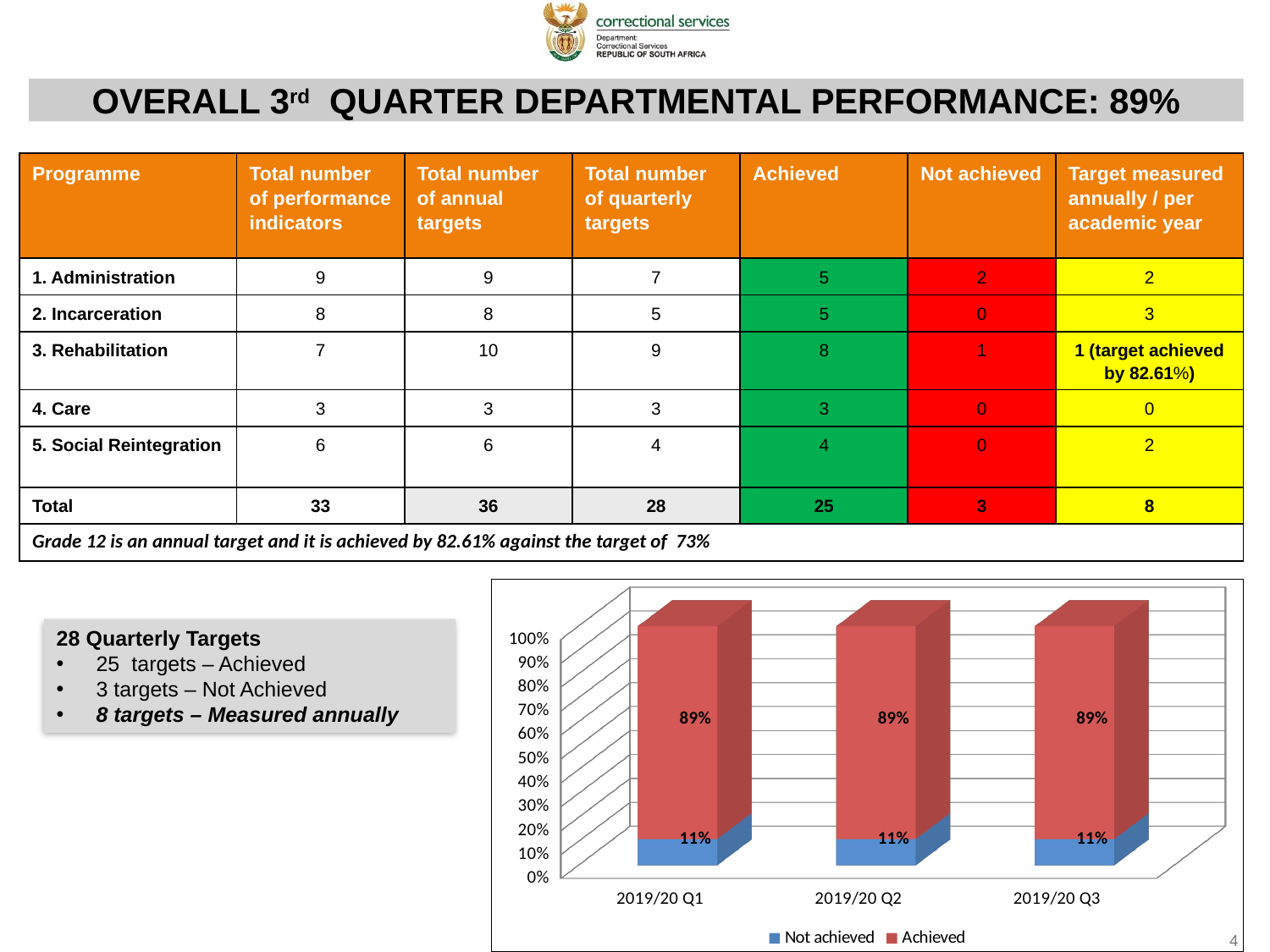
In the chart, what is the difference between the Achieved and Not achieved values for 2019/20 Q2? 78% How many quarters are plotted on the x axis of the chart? 3 What type of chart is shown on the slide? stacked bar chart What is the Achieved value for 2019/20 Q2 in the chart? 89% In the chart, which is larger for 2019/20 Q1: the Achieved value or the Not achieved value? Achieved Which series is shown in blue in the chart legend? Not achieved What is the label of the first category on the x axis of the chart? 2019/20 Q1 How many series does the chart legend list? 2 What is the Achieved value for 2019/20 Q3 in the chart? 89% What is the total of the stacked bar for 2019/20 Q3 in the chart? 100% Does the Achieved value change across the three quarters in the chart, or stay the same? stays the same What is the Not achieved value for 2019/20 Q1 in the chart? 11%